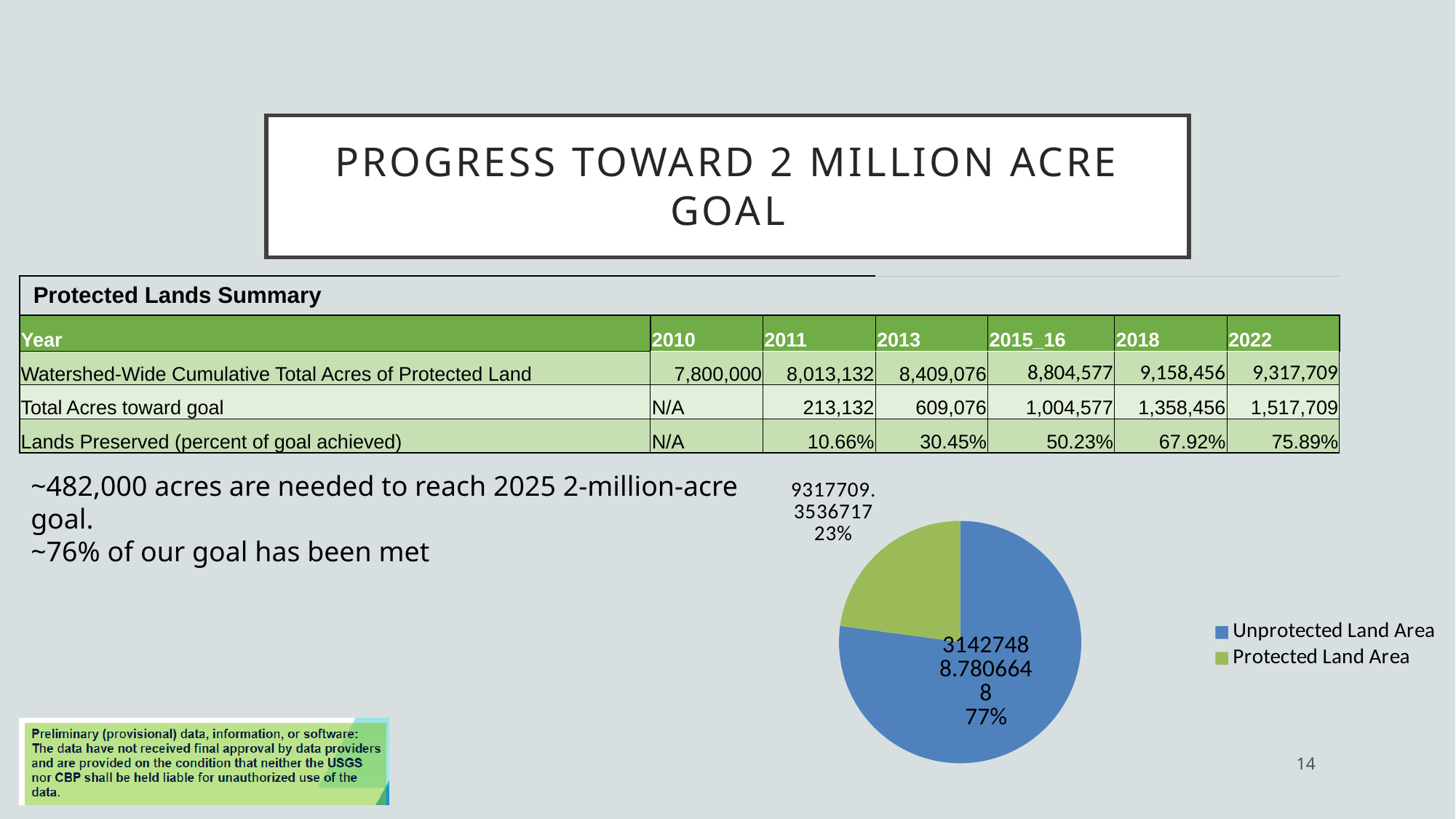
What is the difference in percentage points between the Unprotected Land Area and Protected Land Area shares in the pie chart? 54 What kind of chart is shown on the slide? pie chart What colour is the Protected Land Area slice in the pie chart? green What value is printed on the Protected Land Area slice of the pie chart? 9317709.3536717 Which slice of the pie chart is the largest? Unprotected Land Area How many slices does the pie chart have? 2 How many entries does the pie chart's legend list? 2 What share of the pie chart is Protected Land Area? 23% What share of the pie chart is Unprotected Land Area? 77% What colour is the Unprotected Land Area slice in the pie chart? blue In the pie chart, which is larger: Protected Land Area or Unprotected Land Area? Unprotected Land Area Which slice of the pie chart is the smallest? Protected Land Area